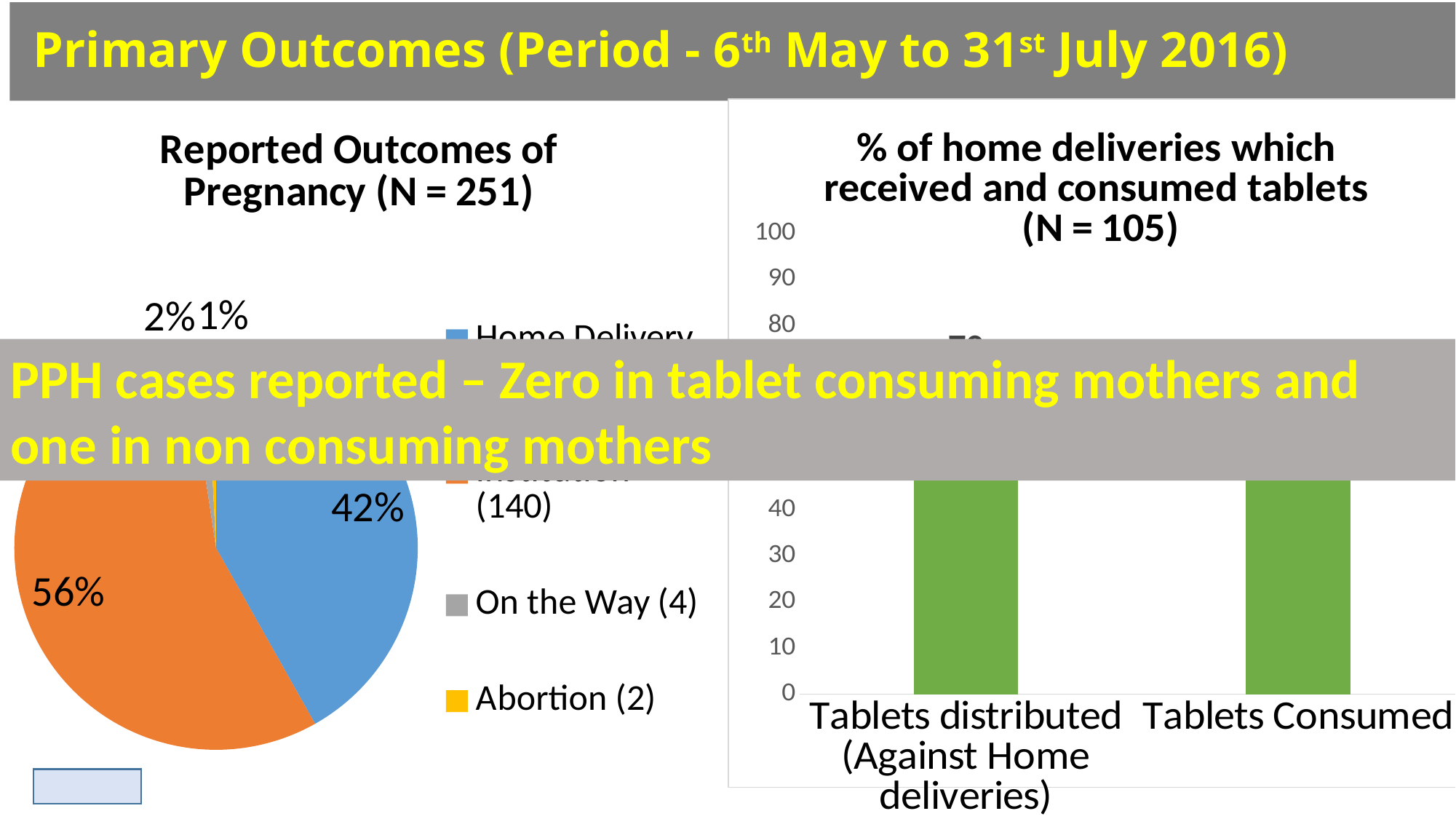
What type of chart is '% of home deliveries which received and consumed tablets'? Bar chart How many categories does the pie chart 'Reported Outcomes of Pregnancy' show? 4 What type of chart is 'Reported Outcomes of Pregnancy'? Pie chart In the pie chart 'Reported Outcomes of Pregnancy', what percentage is shown for Institution? 56% In the pie chart 'Reported Outcomes of Pregnancy', which category has the largest slice? Institution In the pie chart 'Reported Outcomes of Pregnancy', which is larger: the Home Delivery slice or the Institution slice? Institution In the pie chart 'Reported Outcomes of Pregnancy', what percentage is shown for Home Delivery? 42% How many bars does the chart '% of home deliveries which received and consumed tablets' show? 2 In the pie chart 'Reported Outcomes of Pregnancy', how many cases does the legend give for 'On the Way'? 4 In the pie chart 'Reported Outcomes of Pregnancy', how many percentage points larger is the Institution slice than the Home Delivery slice? 14 In the chart '% of home deliveries which received and consumed tablets', is the value for Tablets Consumed greater or less than 30? greater In the pie chart 'Reported Outcomes of Pregnancy', how many cases does the legend give for 'Abortion'? 2